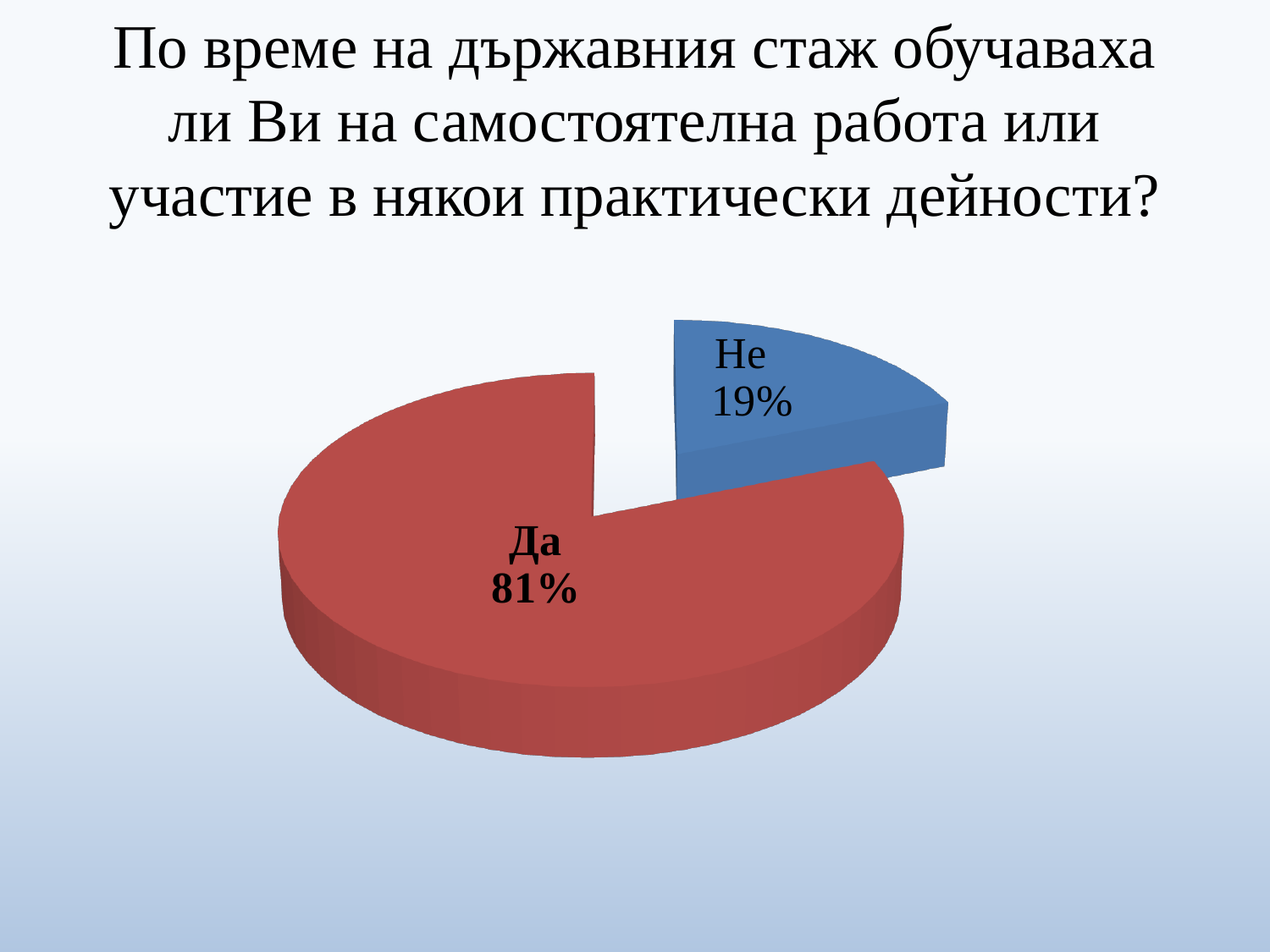
What percentage of the pie is labelled "Не"? 19% How many slices does the pie chart have? 2 Which slice of the pie is the largest? Да What percentage of the pie is labelled "Да"? 81% Which slice is larger, "Да" or "Не"? Да What colour is the "Да" slice? red What colour is the "Не" slice? blue What share of the pie does the "Не" slice represent? 19% What kind of chart is shown on the slide? pie chart What is the difference in percentage points between the "Да" and "Не" slices? 62 Which slice of the pie is the smallest? Не